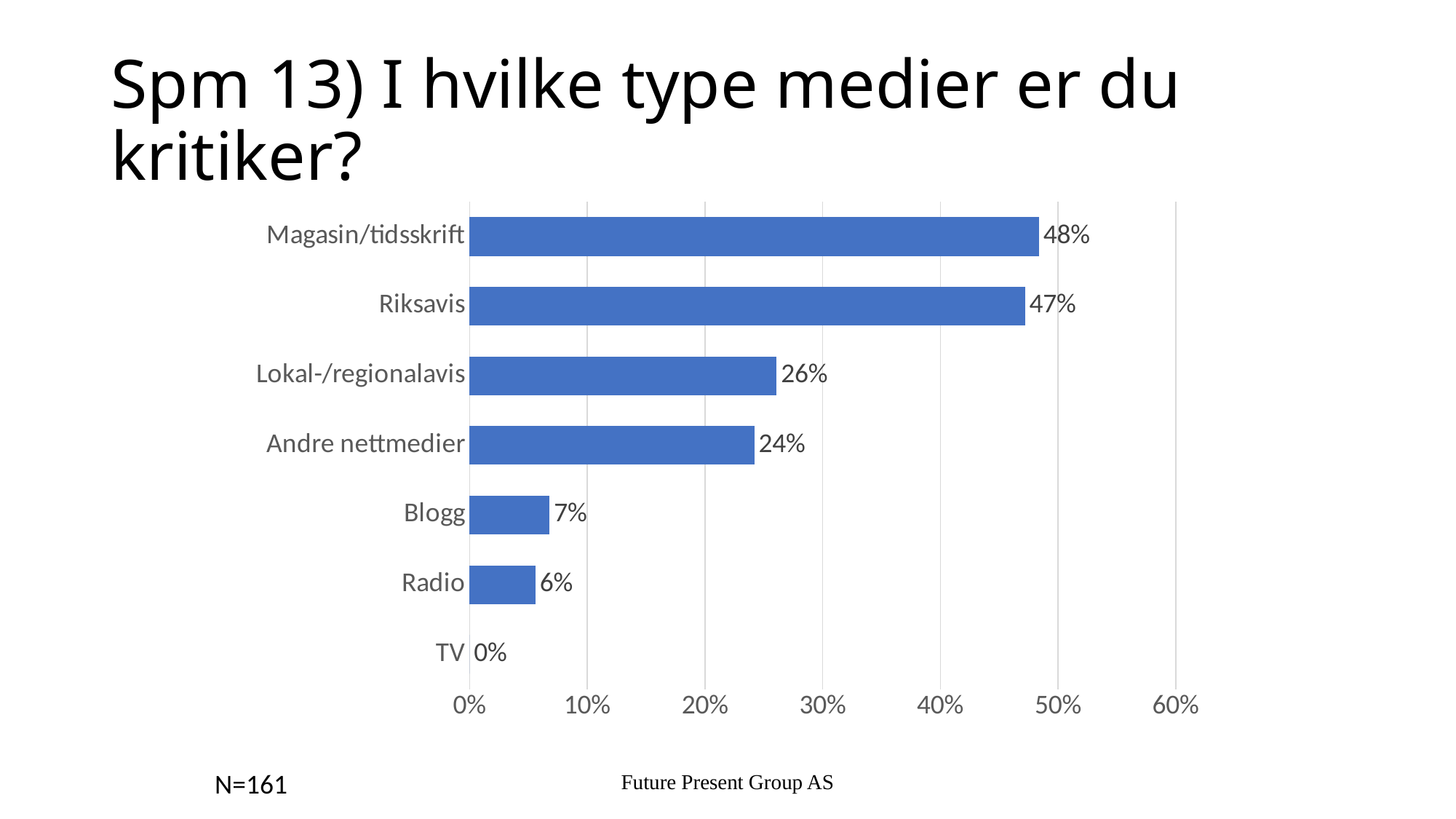
Which category has the lowest value? TV What is the value for TV? 0% What is the difference between the values for Riksavis and Andre nettmedier? 23% What is the value for Magasin/tidsskrift? 48% What kind of chart is shown on the slide? bar chart What is the value for Blogg? 7% Is the value for Riksavis greater or less than 40%? greater How many categories are shown in the chart? 7 What is the value for Lokal-/regionalavis? 26% Which category has the highest value? Magasin/tidsskrift What is the sample size (N) stated on the slide? N=161 Which is larger, the value for Lokal-/regionalavis or the value for Andre nettmedier? Lokal-/regionalavis